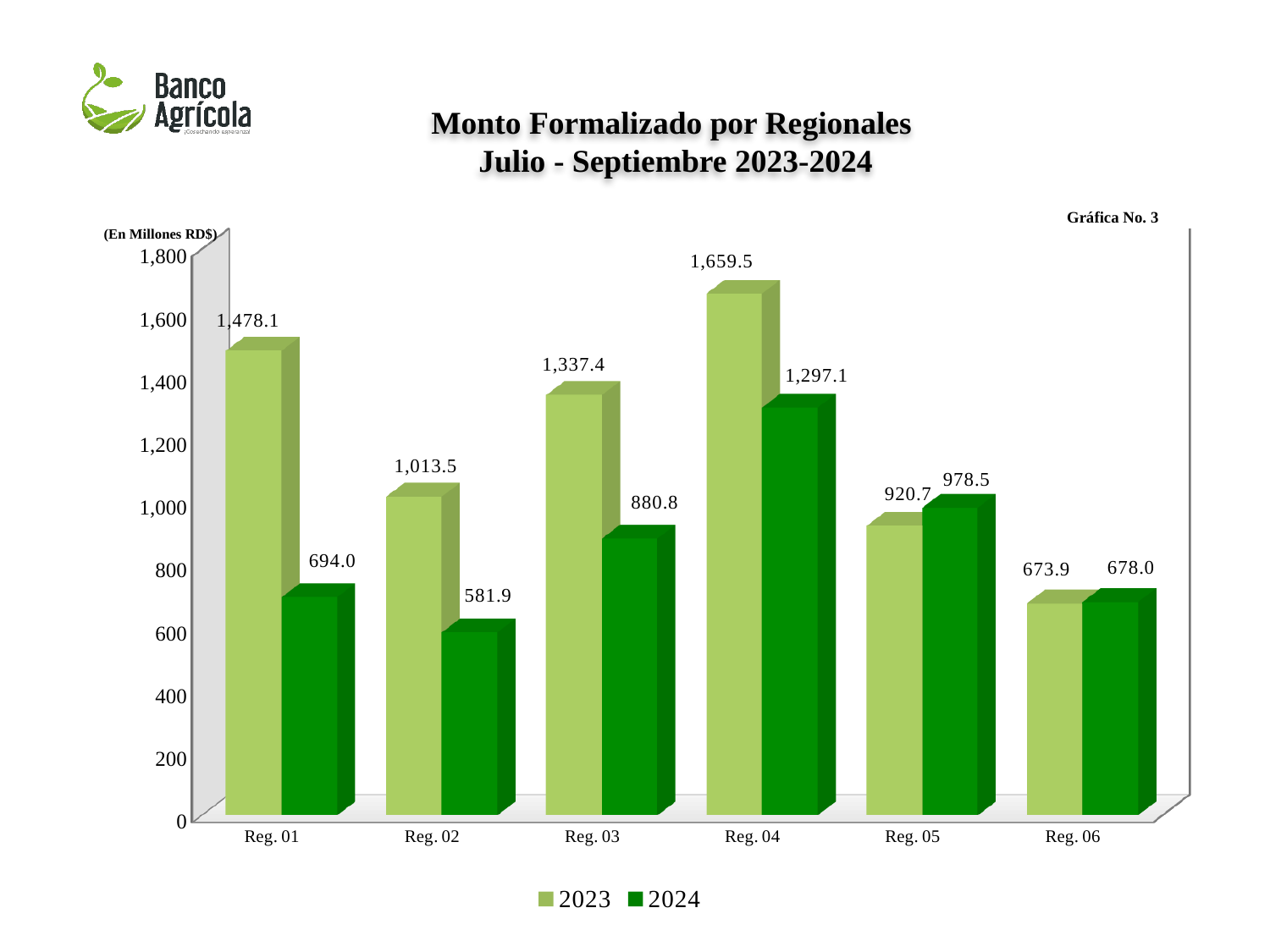
Which is larger for Reg. 03, the 2023 value or the 2024 value? 2023 Which region has the highest 2023 value? Reg. 04 How many regions are shown on the x axis? 6 Is the 2024 value for Reg. 04 greater or less than 1,200? greater What is the difference between the 2023 and 2024 values for Reg. 01? 784.1 What is the title of the chart? Monto Formalizado por Regionales Julio - Septiembre 2023-2024 What is the 2023 value for Reg. 04? 1,659.5 What is the 2024 value for Reg. 05? 978.5 What is the 2024 value for Reg. 02? 581.9 What kind of chart is shown on the slide? Bar chart How many series does the legend list? 2 Which region has the lowest 2024 value? Reg. 02